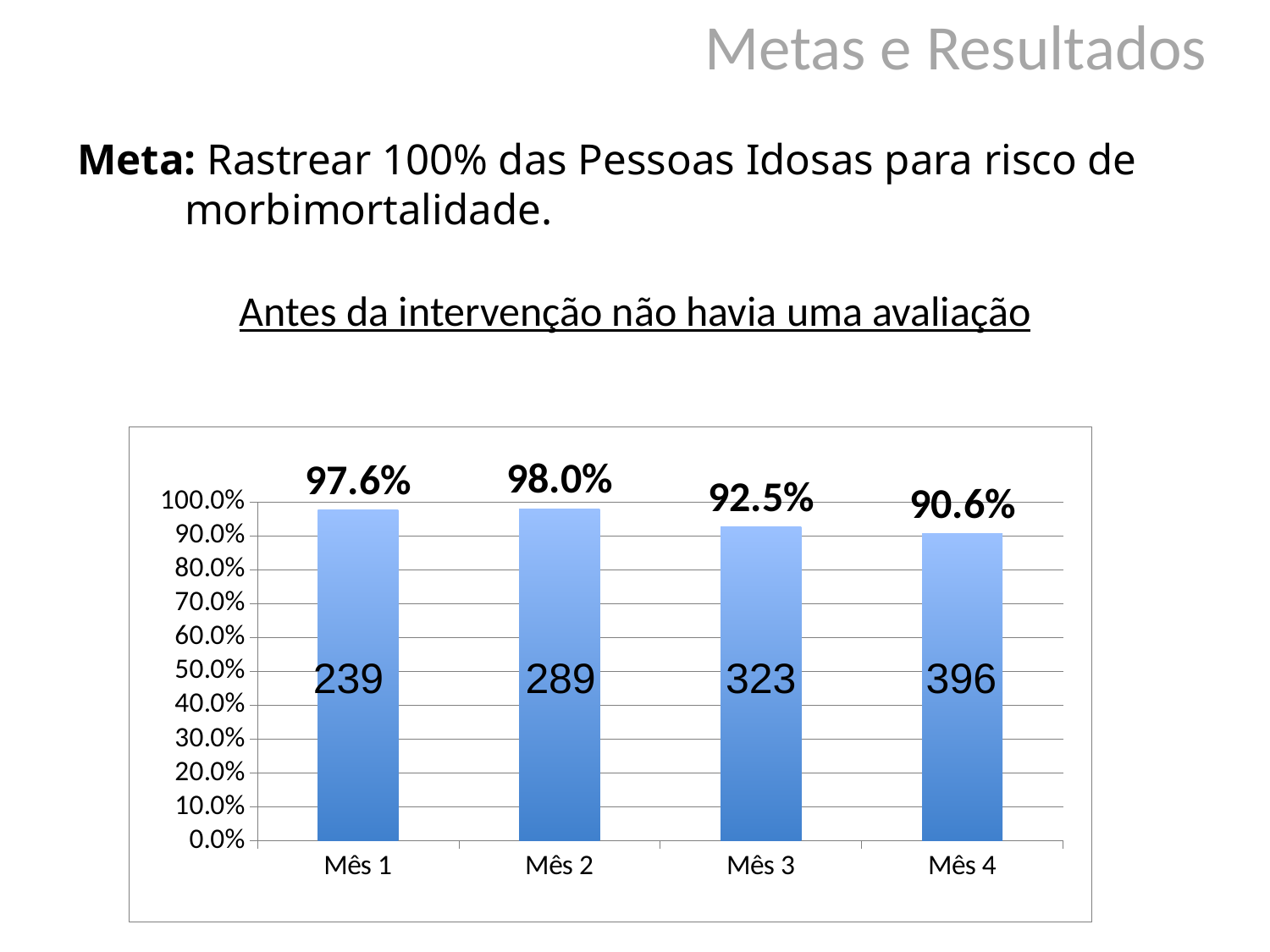
What kind of chart is shown on the slide? Bar chart What percentage is shown for Mês 3? 92.5% How many months (categories) are shown on the x axis? 4 What number is printed inside the bar for Mês 2? 289 Which month has the lowest percentage? Mês 4 What is the difference between the numbers printed inside the bars for Mês 4 and Mês 1? 157 Which has a higher percentage, Mês 1 or Mês 3? Mês 1 Which month has the highest percentage? Mês 2 What percentage is shown for Mês 1? 97.6% What is the difference in percentage points between Mês 2 and Mês 4? 7.4 Do the percentages rise or fall from Mês 2 to Mês 4? Fall What number is printed inside the bar for Mês 4? 396